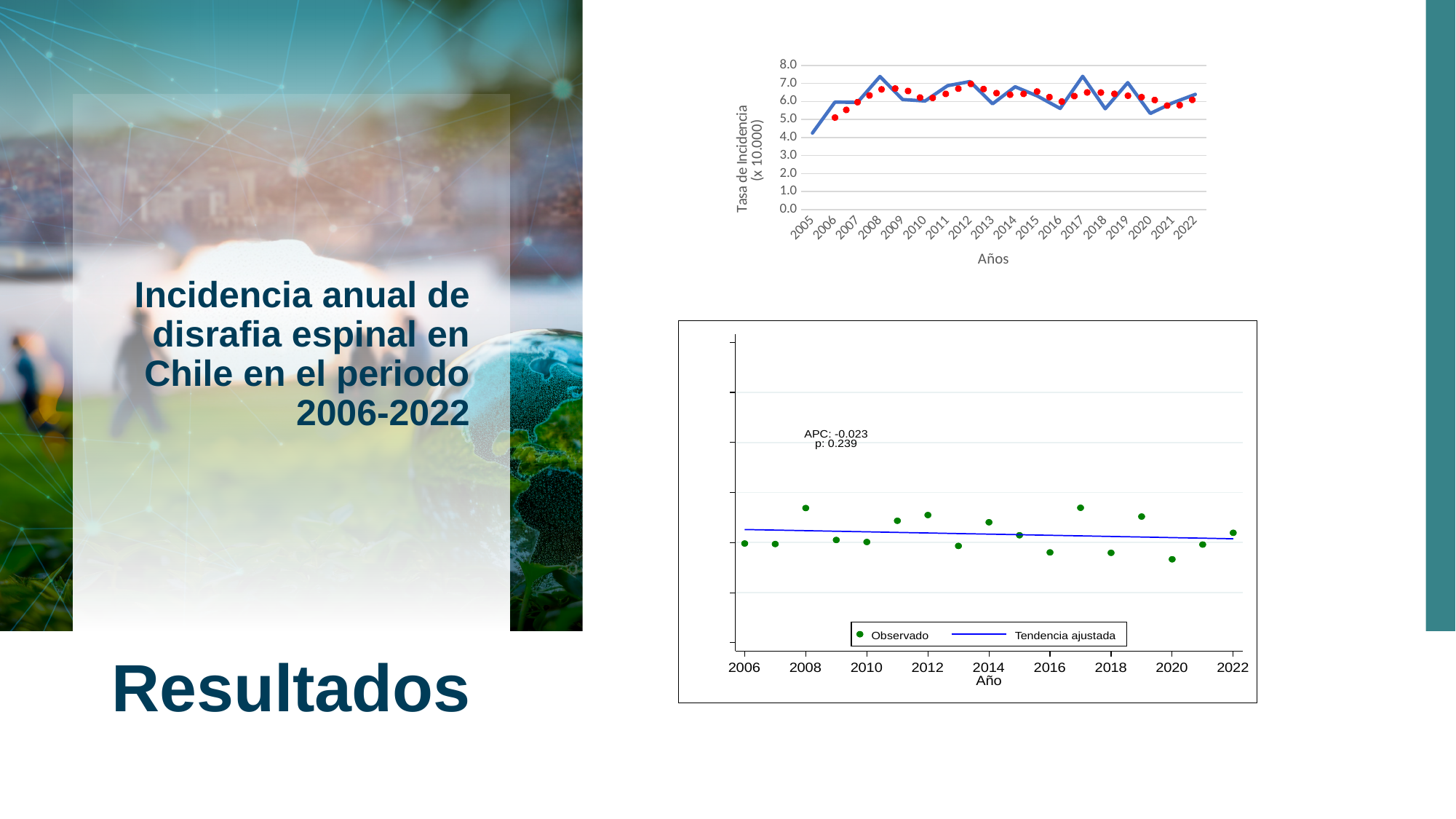
In the bottom chart, how many series does the legend list? 2 What kind of chart is the top chart on the slide? line chart In the top chart, is the value for 2020 greater or less than 6.0? less In the bottom chart, what APC value is printed on the plot? -0.023 In the top chart, how many years are plotted along the x axis? 18 In the top chart, is the value for 2008 greater or less than 7.0? greater What is the y-axis title of the top chart? Tasa de Incidencia (x 10.000) In the top chart, which year has the lowest incidence rate? 2005 In the top chart, is the value for 2017 greater or less than 7.0? greater In the bottom chart, does the fitted trend line (Tendencia ajustada) rise or fall from 2006 to 2022? fall In the bottom chart, what p value is printed on the plot? 0.239